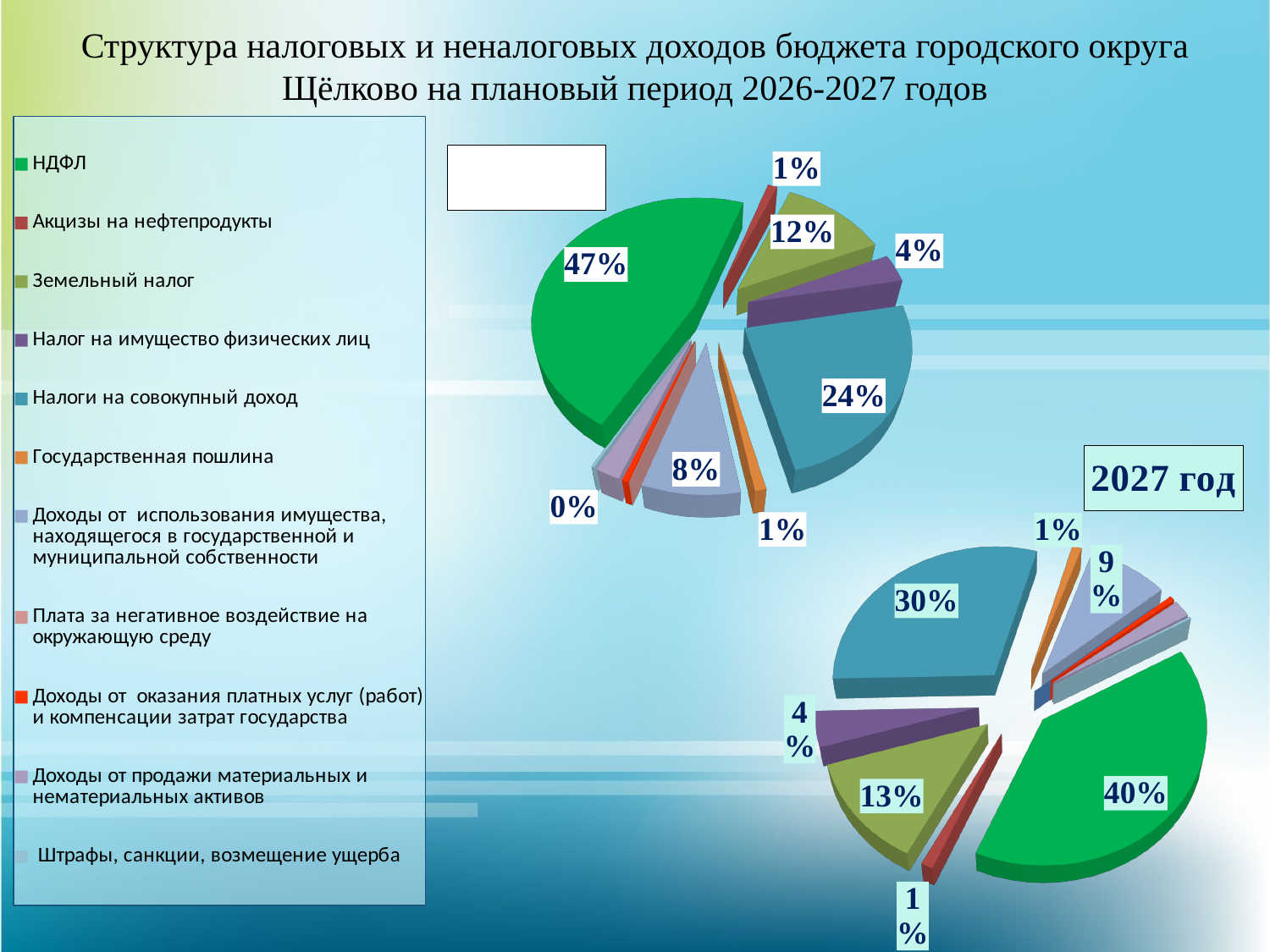
In the upper pie chart, what share does Земельный налог have? 12% Which category has the largest slice in the pie chart labelled 2027 год? НДФЛ What is the difference between the НДФЛ share in the upper pie chart and the НДФЛ share in the pie chart labelled 2027 год? 7% In the upper pie chart, what share does Налог на имущество физических лиц have? 4% In the pie chart labelled 2027 год, what share do Налоги на совокупный доход have? 30% How many categories does the legend on the left of the slide list? 11 In the upper pie chart, what share do Налоги на совокупный доход have? 24% In the pie chart labelled 2027 год, what share does Земельный налог have? 13% In the pie chart labelled 2027 год, what share does НДФЛ have? 40% In the pie chart labelled 2027 год, which is larger: the share of НДФЛ or the share of Налоги на совокупный доход? НДФЛ What kind of chart is the upper chart on the slide? pie chart In the upper pie chart, what share does НДФЛ have? 47%